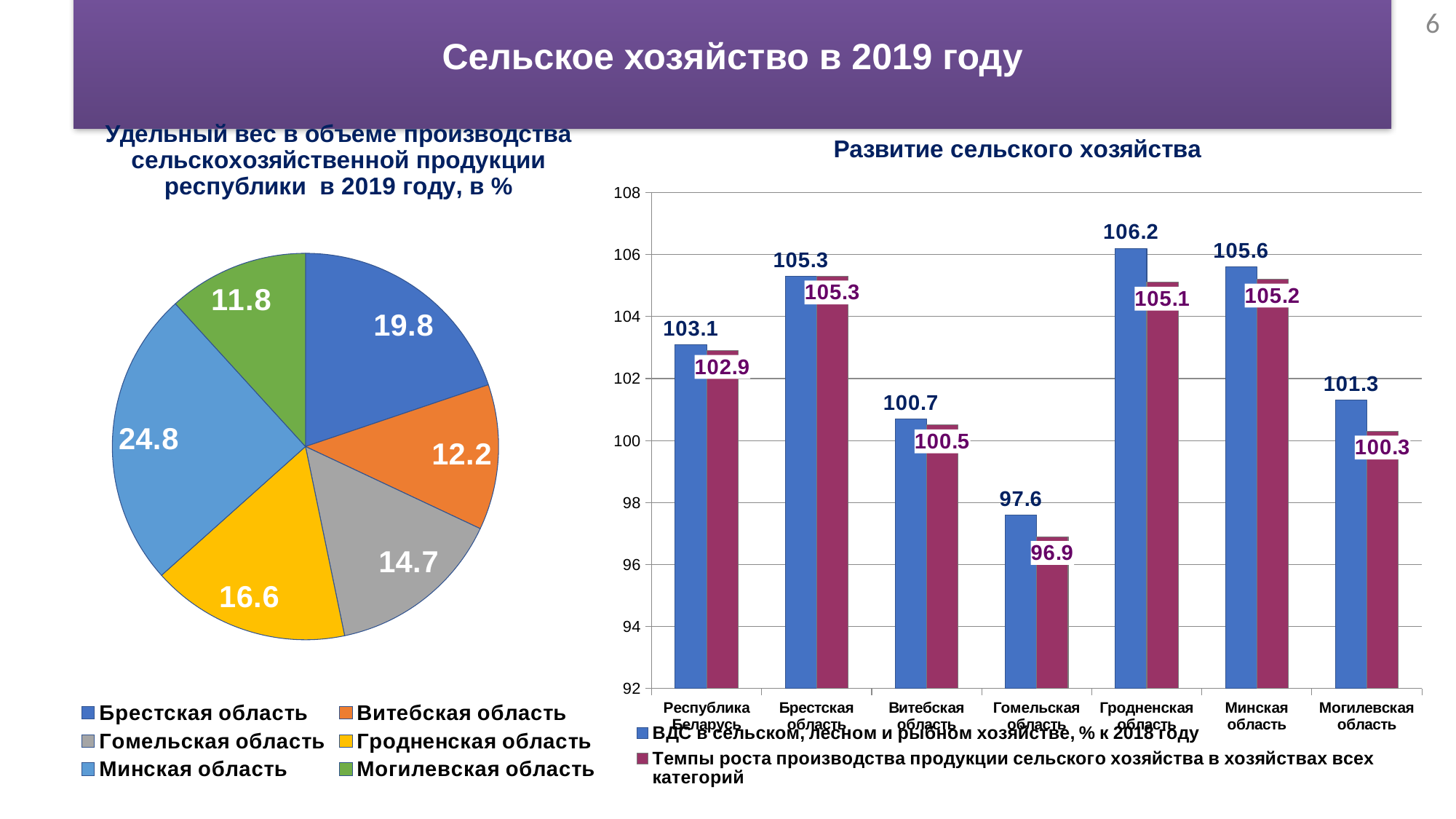
On the pie chart on the left, which region has the largest share? Минская область On the chart 'Развитие сельского хозяйства', which category has the lowest value for ВДС в сельском, лесном и рыбном хозяйстве? Гомельская область On the chart 'Развитие сельского хозяйства', what is the value of Темпы роста производства продукции сельского хозяйства for Гомельская область? 96.9 On the pie chart on the left, how many regions are shown? 6 On the pie chart on the left, what is the share for Минская область? 24.8 On the chart 'Развитие сельского хозяйства', which is larger for Могилевская область: ВДС в сельском, лесном и рыбном хозяйстве or Темпы роста производства продукции сельского хозяйства? ВДС в сельском, лесном и рыбном хозяйстве On the chart 'Развитие сельского хозяйства', how many series does the legend list? 2 What kind of chart is the chart 'Развитие сельского хозяйства'? Bar chart On the chart 'Развитие сельского хозяйства', what is the difference between the two series for Республика Беларусь? 0.2 On the pie chart on the left, which region has the smallest share? Могилевская область On the chart 'Развитие сельского хозяйства', what is the value of ВДС в сельском, лесном и рыбном хозяйстве for Гродненская область? 106.2 On the pie chart on the left, what is the difference between the shares of Брестская область and Витебская область? 7.6